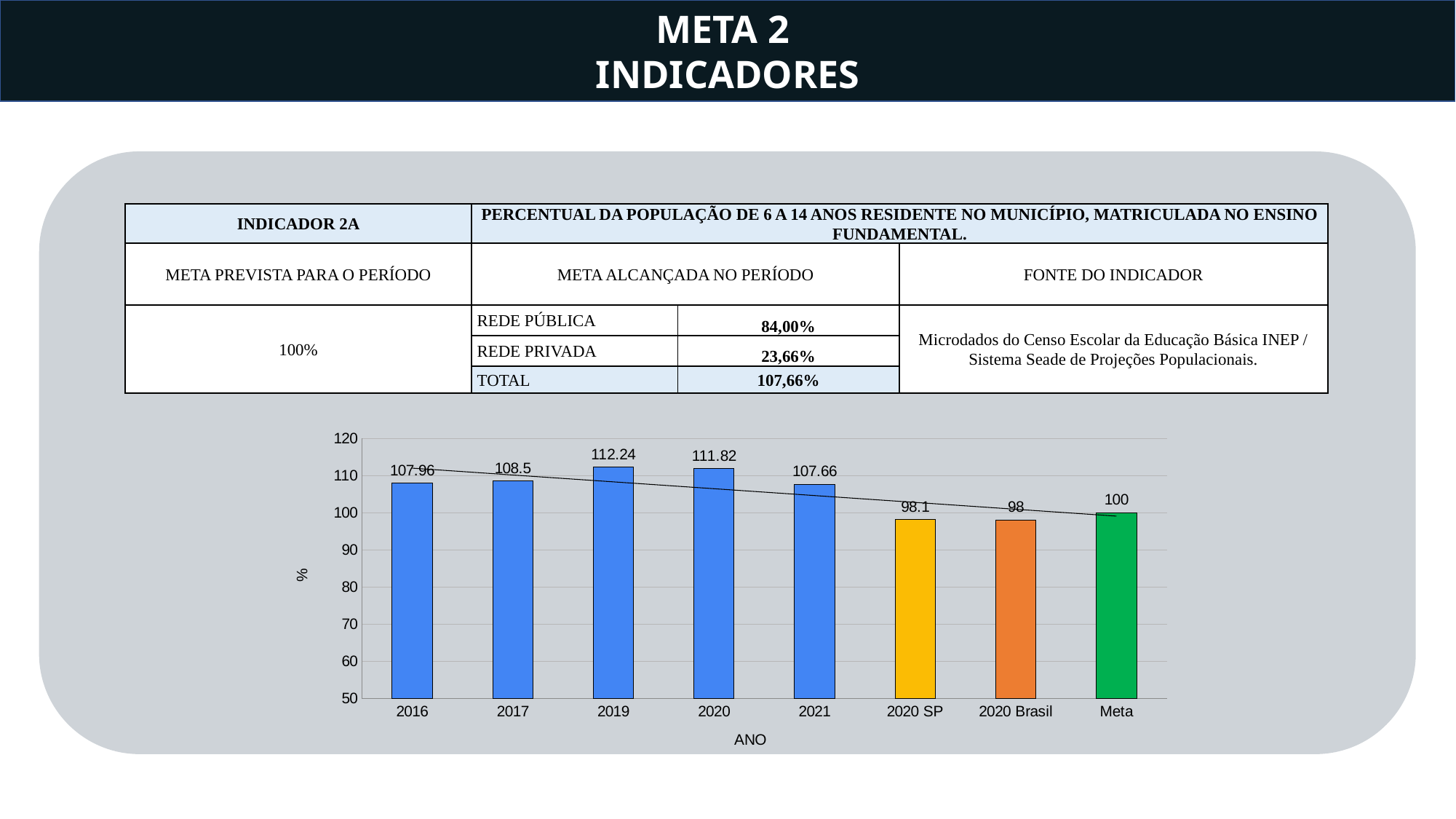
What kind of chart is shown on the slide? bar chart Which is larger in the chart, the value for 2017 or the value for 2016? 2017 Which category has the lowest value in the chart? 2020 Brasil What is the label of the x axis of the chart? ANO What is the value for 2021 in the chart? 107.66 What is the value for 2020 Brasil in the chart? 98 Is the value for 2020 SP greater or less than 100? less What is the difference between the values for 2019 and 2020 in the chart? 0.42 What is the value for 2020 SP in the chart? 98.1 Which category has the highest value in the chart? 2019 How many bars are shown in the chart? 8 What is the value for 2019 in the chart? 112.24